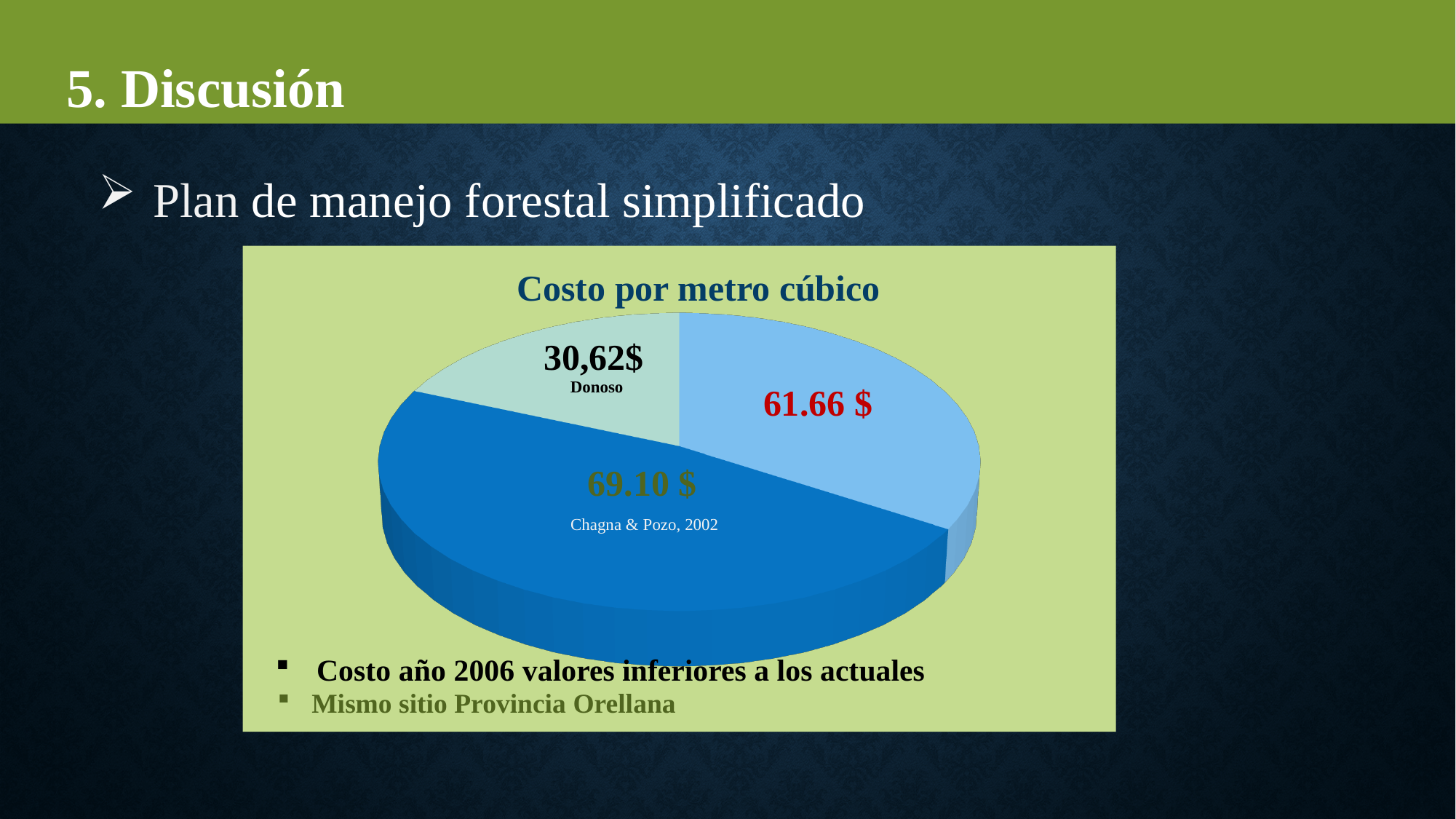
What is the difference between the 61.66 $ slice and the Donoso slice? 31.04 $ What value is shown on the light blue slice on the right of the pie chart? 61.66 $ What kind of chart is shown on the slide? Pie chart What is the cost per cubic metre shown for Chagna & Pozo, 2002? 69.10 $ Which slice of the pie chart has the lowest value? Donoso (30,62$) Which slice of the pie chart has the highest value? Chagna & Pozo, 2002 (69.10 $) What is the cost per cubic metre shown for Donoso? 30,62$ Which slice of the pie chart is coloured dark blue? Chagna & Pozo, 2002 (69.10 $) What is the difference between the 69.10 $ slice and the 61.66 $ slice? 7.44 $ What is the title of the pie chart? Costo por metro cúbico How many slices does the pie chart have? 3 Which is larger, the value for Donoso or the value for Chagna & Pozo, 2002? Chagna & Pozo, 2002